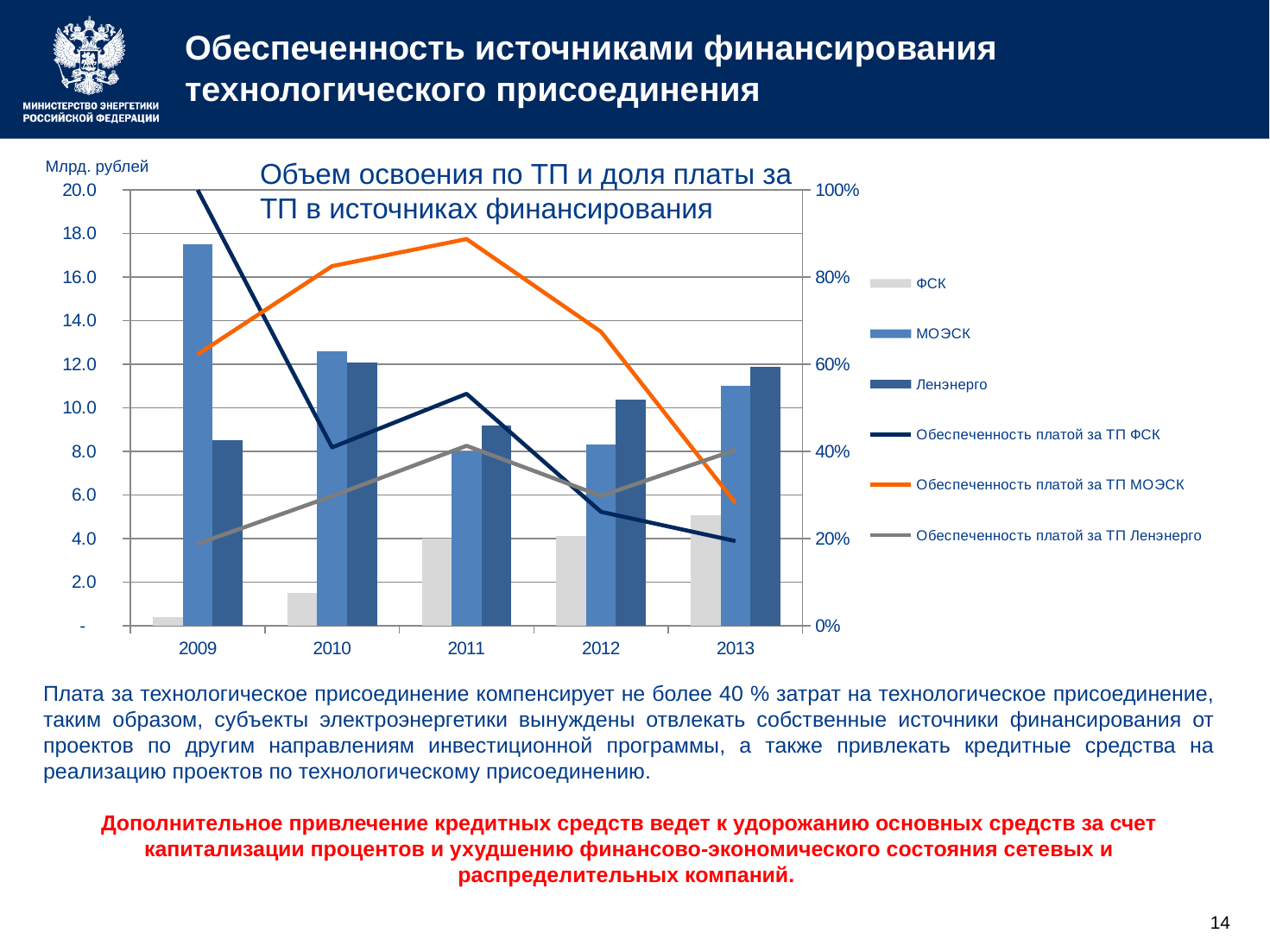
Do the ФСК bars rise or fall from 2009 to 2013? rise Does the Обеспеченность платой за ТП ФСК line rise or fall overall from 2009 to 2013? fall How many years are shown on the x axis? 5 What unit is shown above the left axis of the chart? Млрд. рублей In which year is the МОЭСК bar the highest? 2009 In 2012, which bar is larger: МОЭСК or Ленэнерго? Ленэнерго Is the ФСК bar for 2013 greater or less than 6.0? less How many series does the legend list? 6 Is the МОЭСК bar for 2009 greater or less than 16.0? greater In which year is the ФСК bar the lowest? 2009 What kind of chart is shown on the slide? A combined bar and line chart Is the Обеспеченность платой за ТП МОЭСК line for 2011 greater or less than 80%? greater